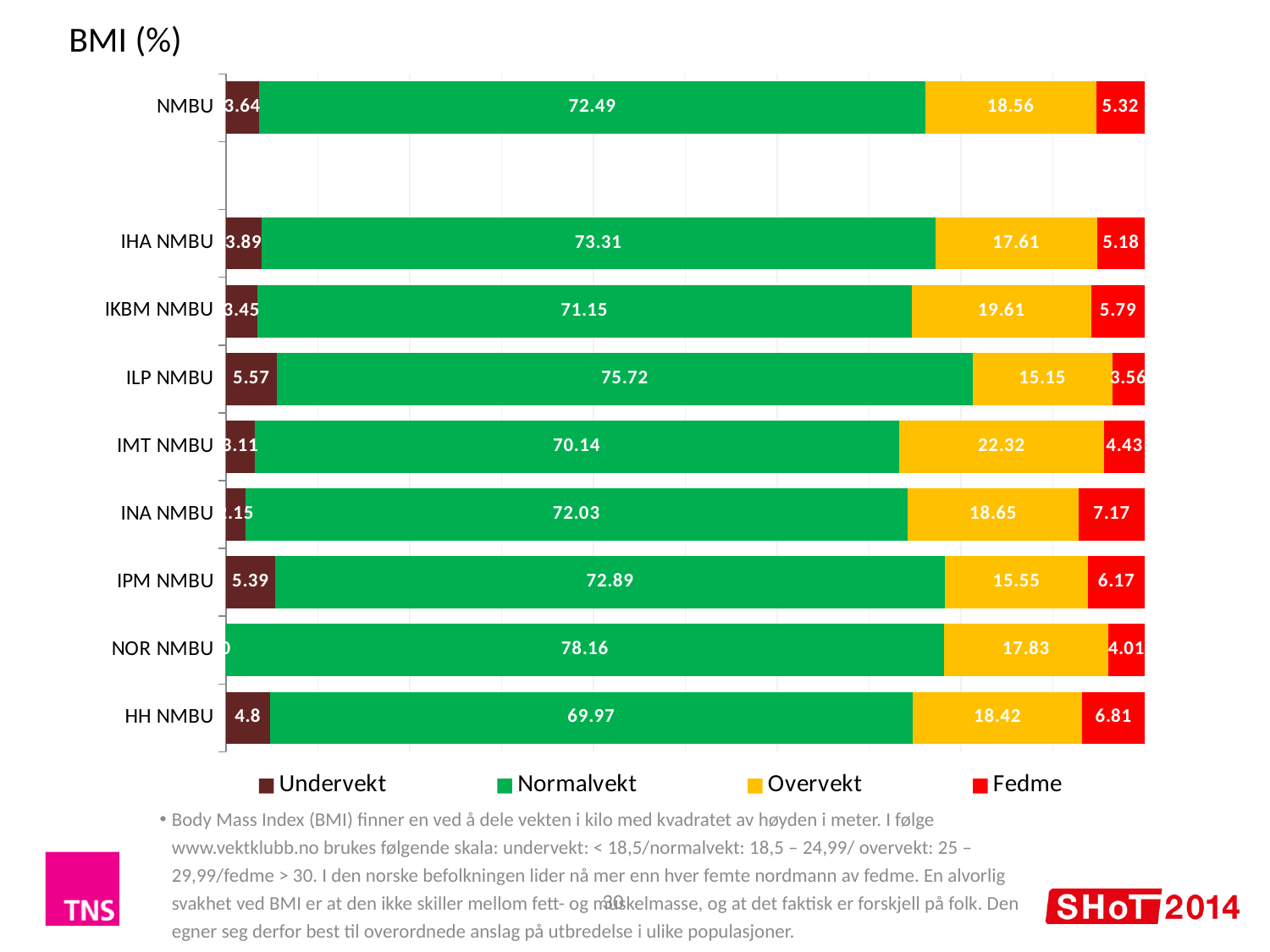
How many series does the legend list? 4 What type of chart is shown on the slide? stacked bar chart What is the Normalvekt value for NOR NMBU? 78.16 What is the Undervekt value for ILP NMBU? 5.57 What is the Overvekt value for IMT NMBU? 22.32 What is the title of the chart? BMI (%) Which category has the highest Overvekt value? IMT NMBU Which category has the highest Normalvekt value? NOR NMBU What is the difference between the Normalvekt values for NOR NMBU and HH NMBU? 8.19 What is the Fedme value for INA NMBU? 7.17 Which category has the lowest Fedme value? ILP NMBU Which is larger, the Fedme value for HH NMBU or for IPM NMBU? HH NMBU